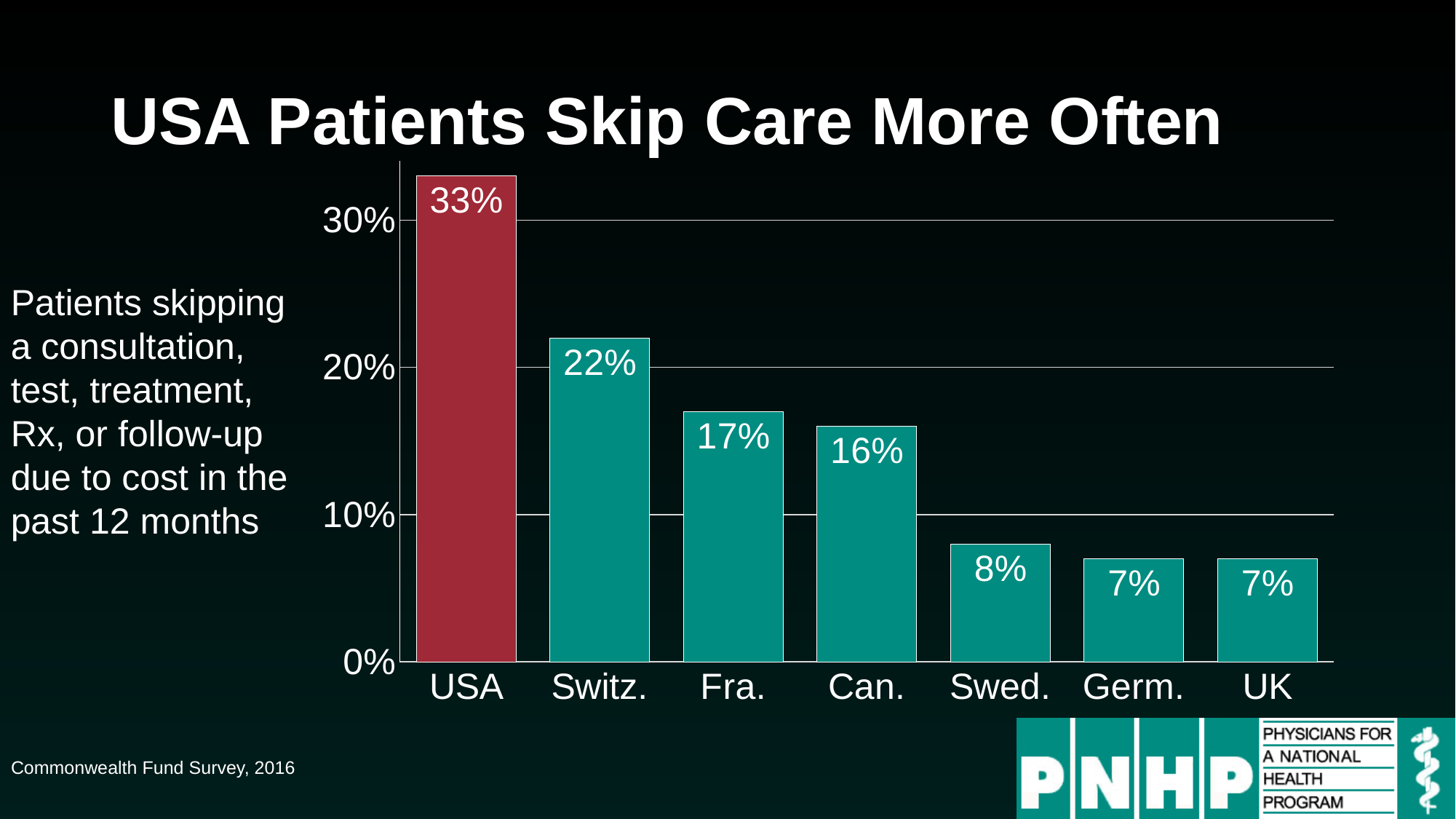
Which country has the highest percentage of patients skipping care? USA What kind of chart is shown on the slide? bar chart What is the value shown for Can.? 16% Which bar is coloured differently from the others? USA What is the difference between the Fra. value and the Swed. value? 9% Is the value for Swed. greater or less than 10%? less What percentage of patients in the USA skipped care due to cost? 33% What is the value shown for Switz.? 22% How many countries are shown on the chart? 7 Which is larger, the value for Fra. or the value for Can.? Fra. What is the difference between the USA value and the Switz. value? 11% Do the values rise or fall moving from left to right across the chart? fall